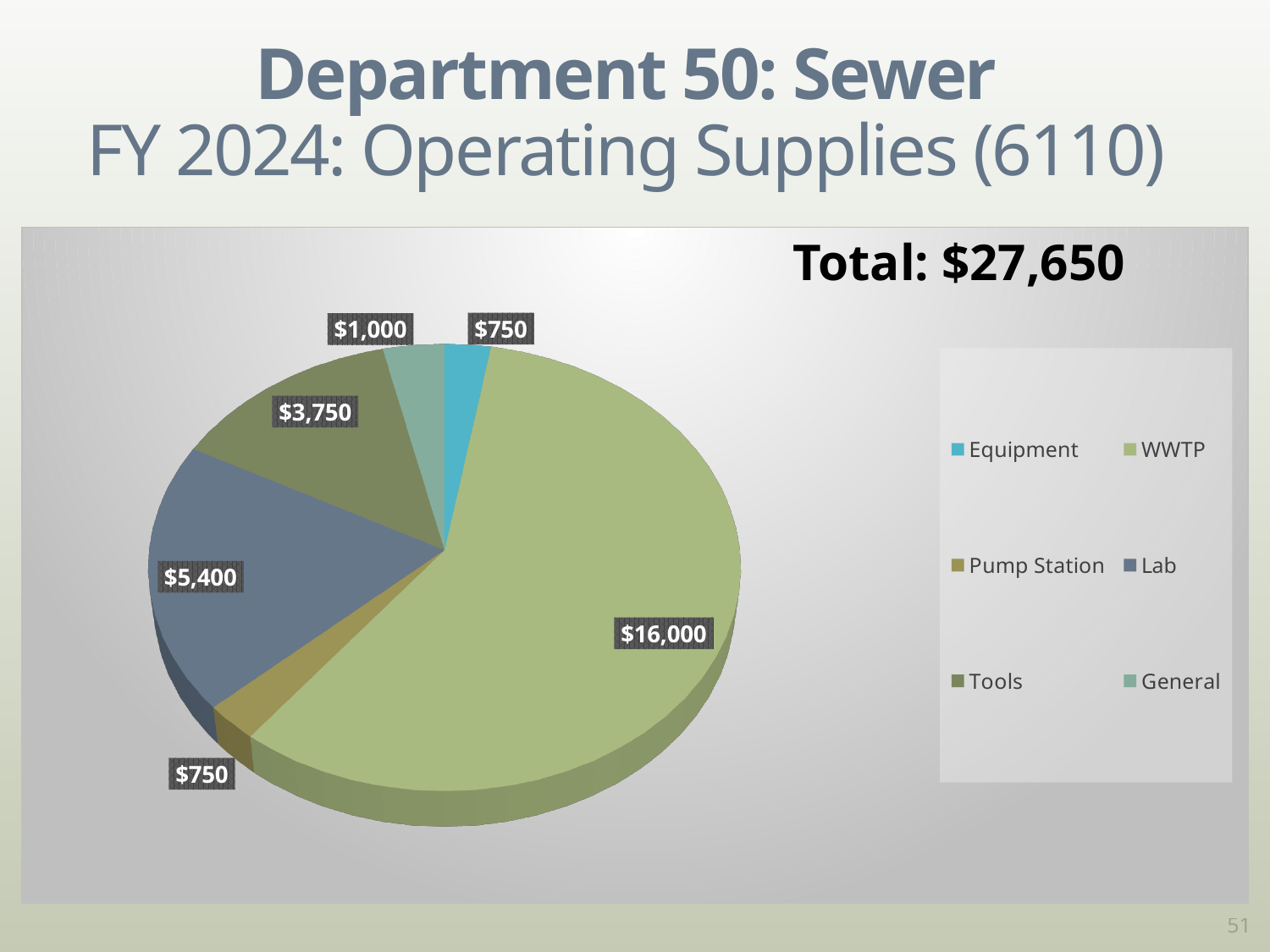
How many slices does the pie chart have? 6 What is the difference between the WWTP value and the Lab value? $10,600 What is the difference between the Lab value and the Tools value? $1,650 Which is larger, the Tools slice or the General slice? Tools What is the value of the General slice? $1,000 What is the value of the Equipment slice? $750 What is the value of the Tools slice? $3,750 Which category has the largest slice of the pie? WWTP What is the value of the WWTP slice? $16,000 What kind of chart is shown on the slide? Pie chart What is the value of the Lab slice? $5,400 What total is printed on the chart? $27,650